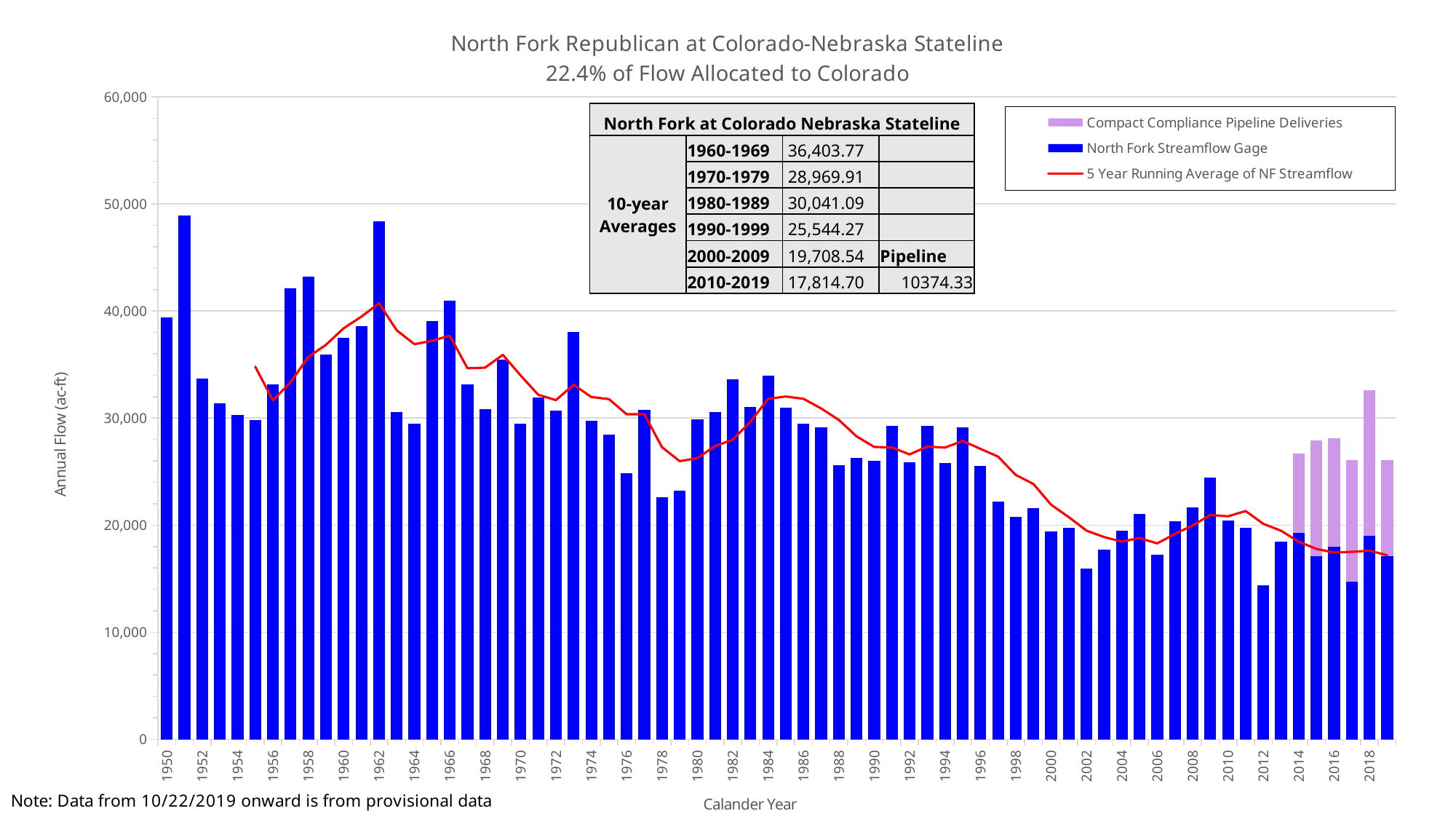
Is the North Fork Streamflow Gage value for 1951 greater or less than 40,000? greater Overall, do the annual streamflow values rise or fall from 1950 to 2019? fall What is the Pipeline value shown in the table for 2010-2019? 10374.33 What is the difference between the 10-year averages for 1960-1969 and 1970-1979? 7,433.86 Which decade in the table has the highest 10-year average? 1960-1969 Is the North Fork Streamflow Gage value for 2012 greater or less than 20,000? less What kind of chart is shown on the slide? combination bar and line chart Which decade in the table has the lowest 10-year average? 2010-2019 Which 10-year average is larger, 1970-1979 or 1980-1989? 1980-1989 According to the table, what is the 10-year average for 1960-1969? 36,403.77 How many series does the chart legend list? 3 According to the table, what is the 10-year average for 2010-2019? 17,814.70